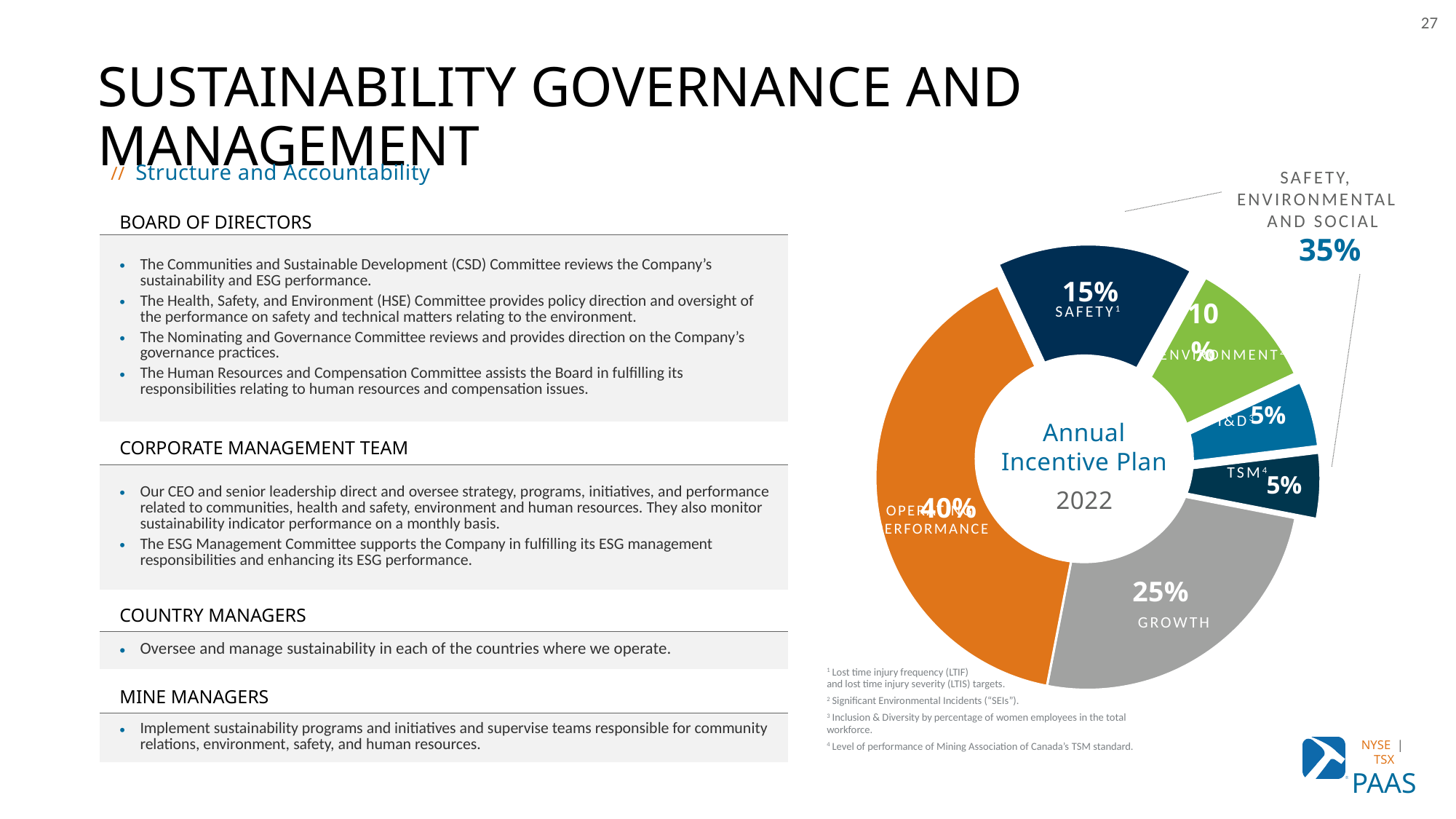
How many slices does the Annual Incentive Plan donut chart have? 6 What percentage of the Annual Incentive Plan is allocated to TSM? 5% What combined percentage does the chart show for Safety, Environmental and Social? 35% Which is larger in the Annual Incentive Plan: Safety or Environment? Safety Which slice of the Annual Incentive Plan chart is the largest? Operating Performance What is the title shown in the centre of the donut chart? Annual Incentive Plan 2022 What kind of chart is shown on the slide? Donut (pie) chart What is the difference between the Operating Performance share and the Growth share in the Annual Incentive Plan? 15% What percentage of the Annual Incentive Plan is allocated to Environment? 10% What percentage of the Annual Incentive Plan is allocated to Growth? 25% What percentage of the Annual Incentive Plan is allocated to Operating Performance? 40% What percentage of the Annual Incentive Plan is allocated to Safety? 15%